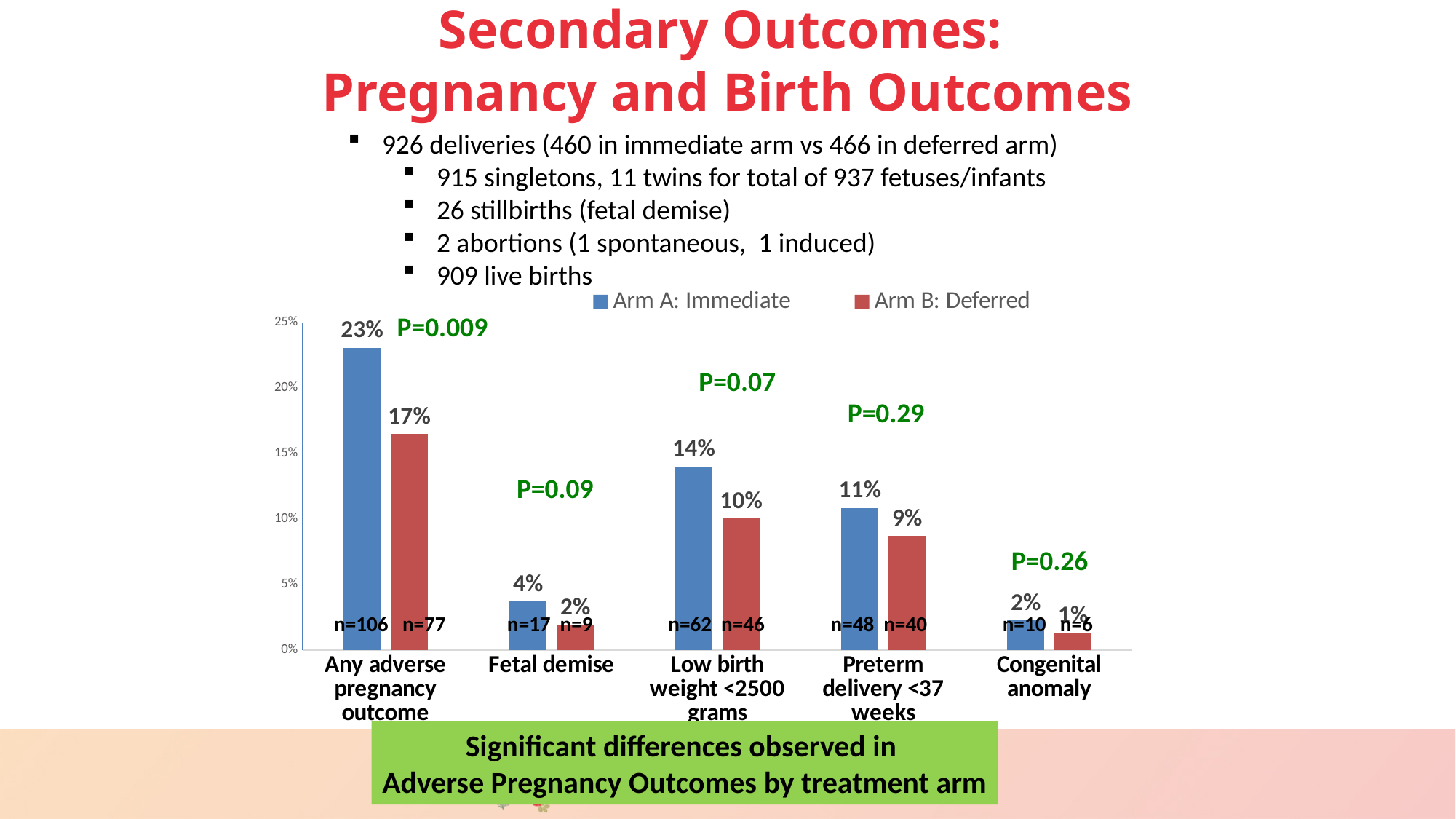
Which category has the lowest value for Arm B: Deferred? Congenital anomaly How many categories are shown on the x axis? 5 What P value is shown for Fetal demise? P=0.09 How many series does the legend list? 2 Which category has the highest value for Arm A: Immediate? Any adverse pregnancy outcome What is the difference between Arm A: Immediate and Arm B: Deferred for Any adverse pregnancy outcome? 6% What is the value for Arm A: Immediate for Any adverse pregnancy outcome? 23% Which arm has the larger value for Low birth weight <2500 grams? Arm A: Immediate What kind of chart is shown on the slide? Bar chart What is the value for Arm A: Immediate for Preterm delivery <37 weeks? 11% What is the value for Arm B: Deferred for Fetal demise? 2% What is the value for Arm B: Deferred for Low birth weight <2500 grams? 10%